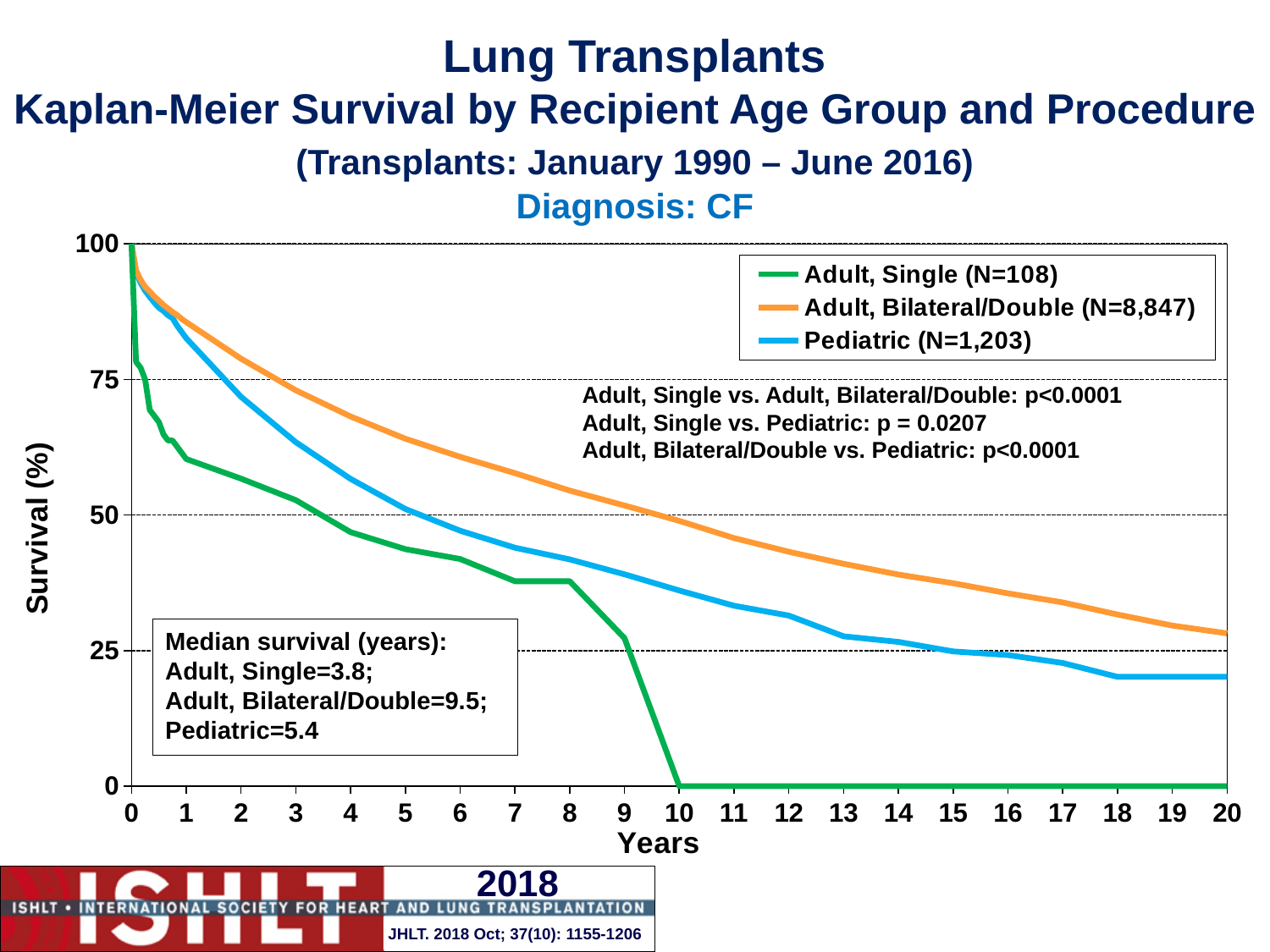
What is the difference in median survival (years) between the Adult, Bilateral/Double group and the Adult, Single group? 5.7 What kind of chart is shown on the slide? Line chart What is the median survival in years for the Adult, Bilateral/Double group? 9.5 Which group has the highest median survival? Adult, Bilateral/Double What is the N for the Pediatric group shown in the legend? 1,203 Do the survival curves rise or fall as years increase along the x axis? Fall What is the median survival in years for the Pediatric group? 5.4 How many series does the legend list? 3 What is the N for the Adult, Single group shown in the legend? 108 Which group has the lowest median survival? Adult, Single At 15 years, which group has higher survival: Adult, Bilateral/Double or Pediatric? Adult, Bilateral/Double Is the survival value for the Adult, Bilateral/Double group at 15 years greater or less than 50? less